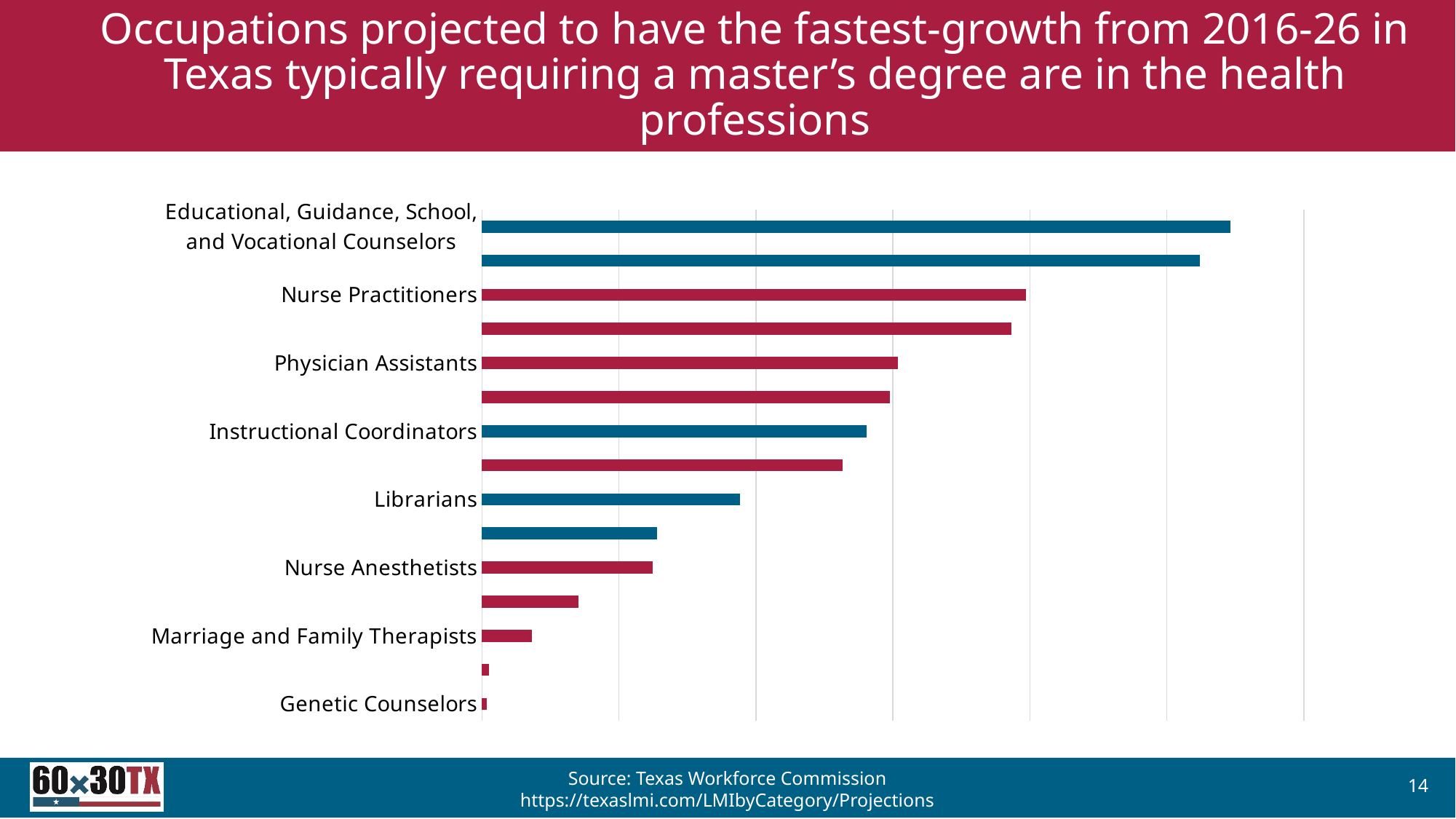
Which has the longer bar, Instructional Coordinators or Marriage and Family Therapists? Instructional Coordinators What colour is the bar for Librarians? blue Which labeled occupation has the longest bar? Educational, Guidance, School, and Vocational Counselors Which has the longer bar, Librarians or Nurse Anesthetists? Librarians Which has the longer bar, Nurse Practitioners or Physician Assistants? Nurse Practitioners How many bars are plotted in the chart? 15 What kind of chart is shown on the slide? bar chart Do the bars get longer or shorter going from the top of the chart to the bottom? shorter How many different bar colours are used in the chart? 2 Which labeled occupation has the shortest bar? Genetic Counselors How many occupation labels are shown on the vertical axis? 8